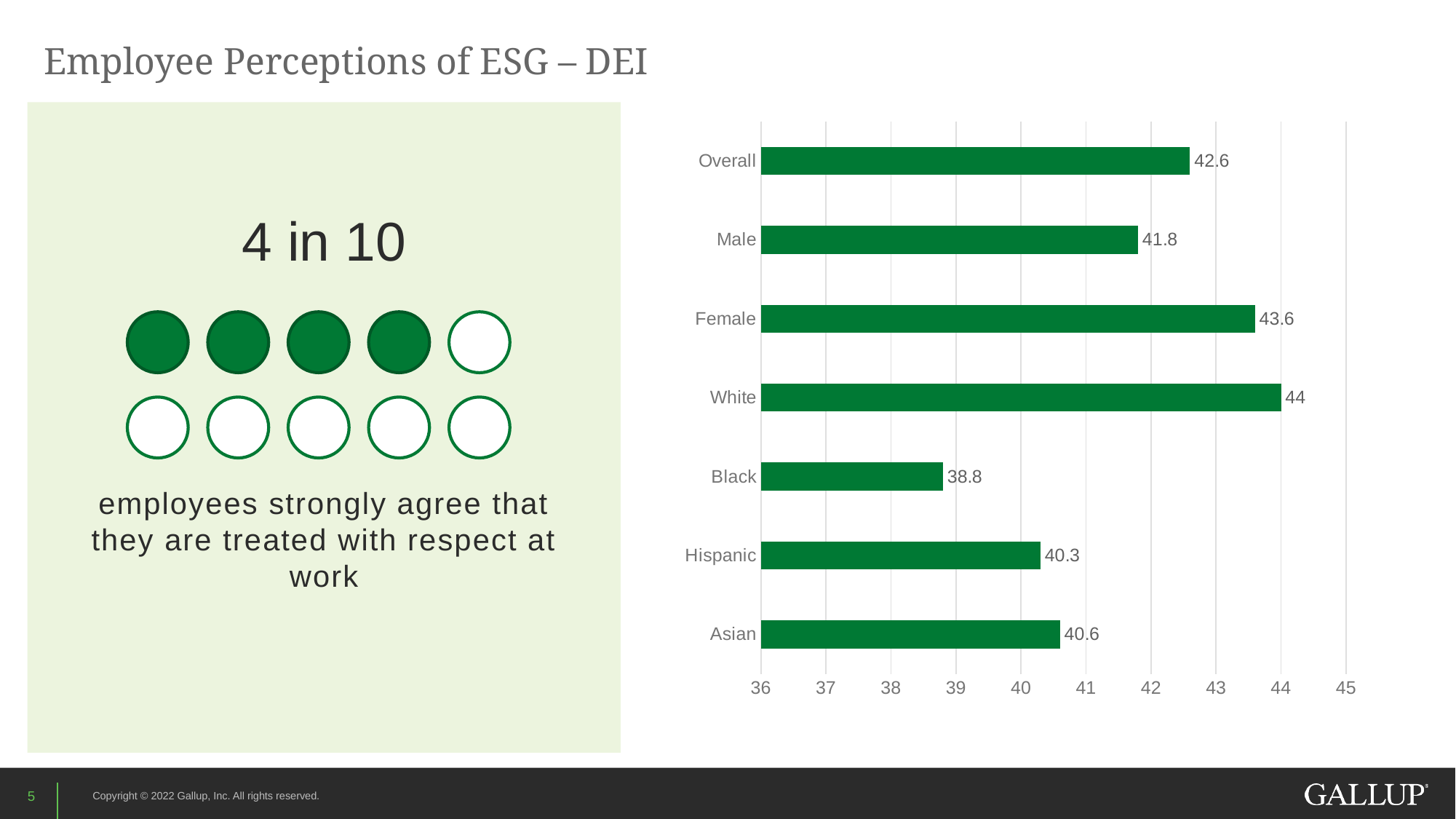
What is the difference between the values for White and Black? 5.2 What is the difference between the values for Female and Male? 1.8 What is the value for Black? 38.8 Which is larger, the value for Asian or the value for Hispanic? Asian What is the value for Hispanic? 40.3 What kind of chart is shown on the slide? bar chart What is the value for Overall? 42.6 What is the value for Female? 43.6 Which category has the lowest value? Black Which category has the highest value? White Is the value for Male greater or less than 40? greater How many categories are shown in the bar chart? 7